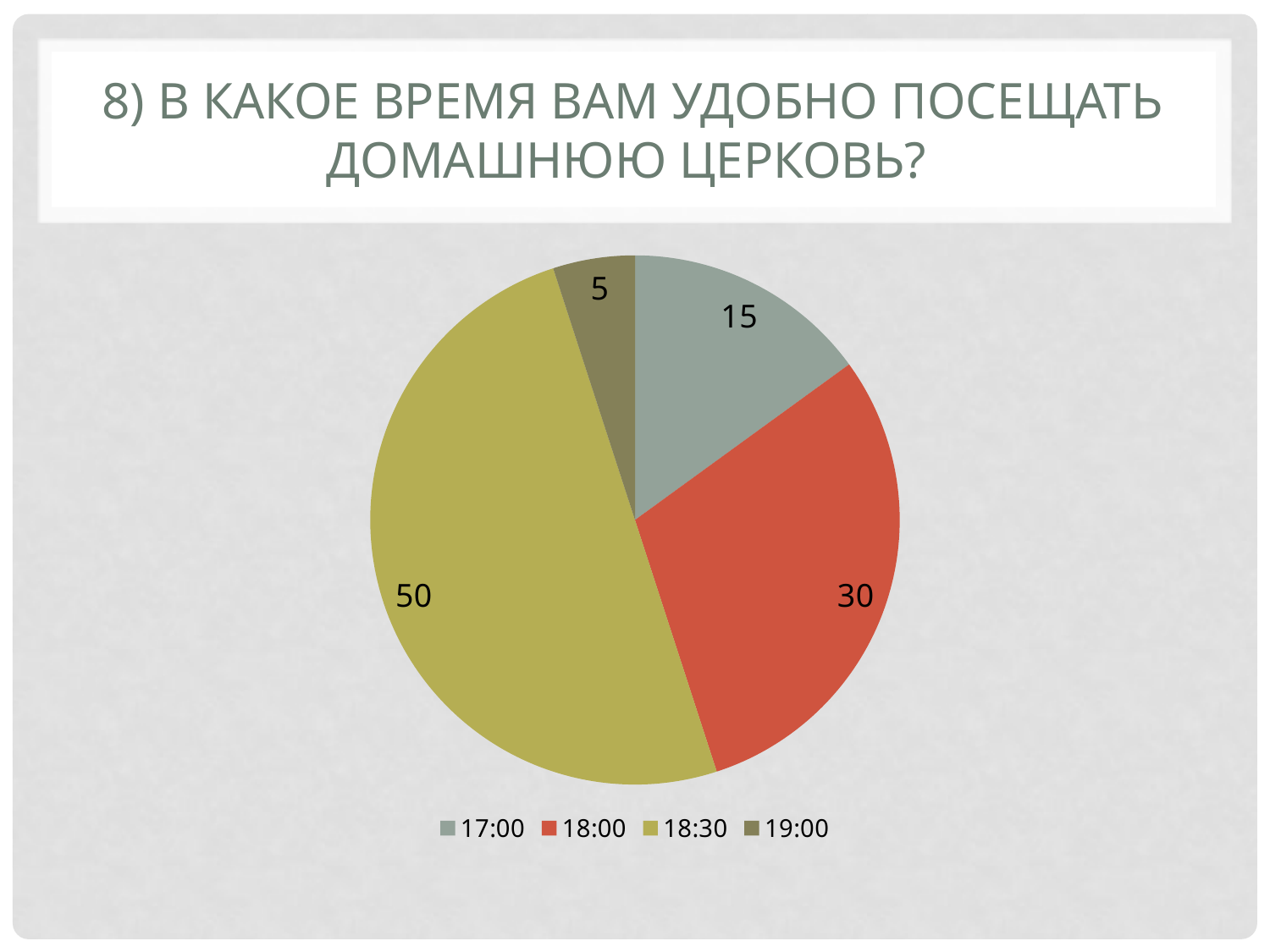
Which is larger, the value for 17:00 or the value for 19:00? 17:00 What share of the pie does the 18:30 slice represent? 50% What is the value for the 17:00 slice? 15 What is the value for the 18:00 slice? 30 How many slices does the pie chart have? 4 Which time has the smallest slice? 19:00 What is the value for the 18:30 slice? 50 What kind of chart is shown on the slide? pie chart Which time has the largest slice? 18:30 What is the value for the 19:00 slice? 5 What is the difference between the values for 18:30 and 18:00? 20 How many entries does the legend list? 4